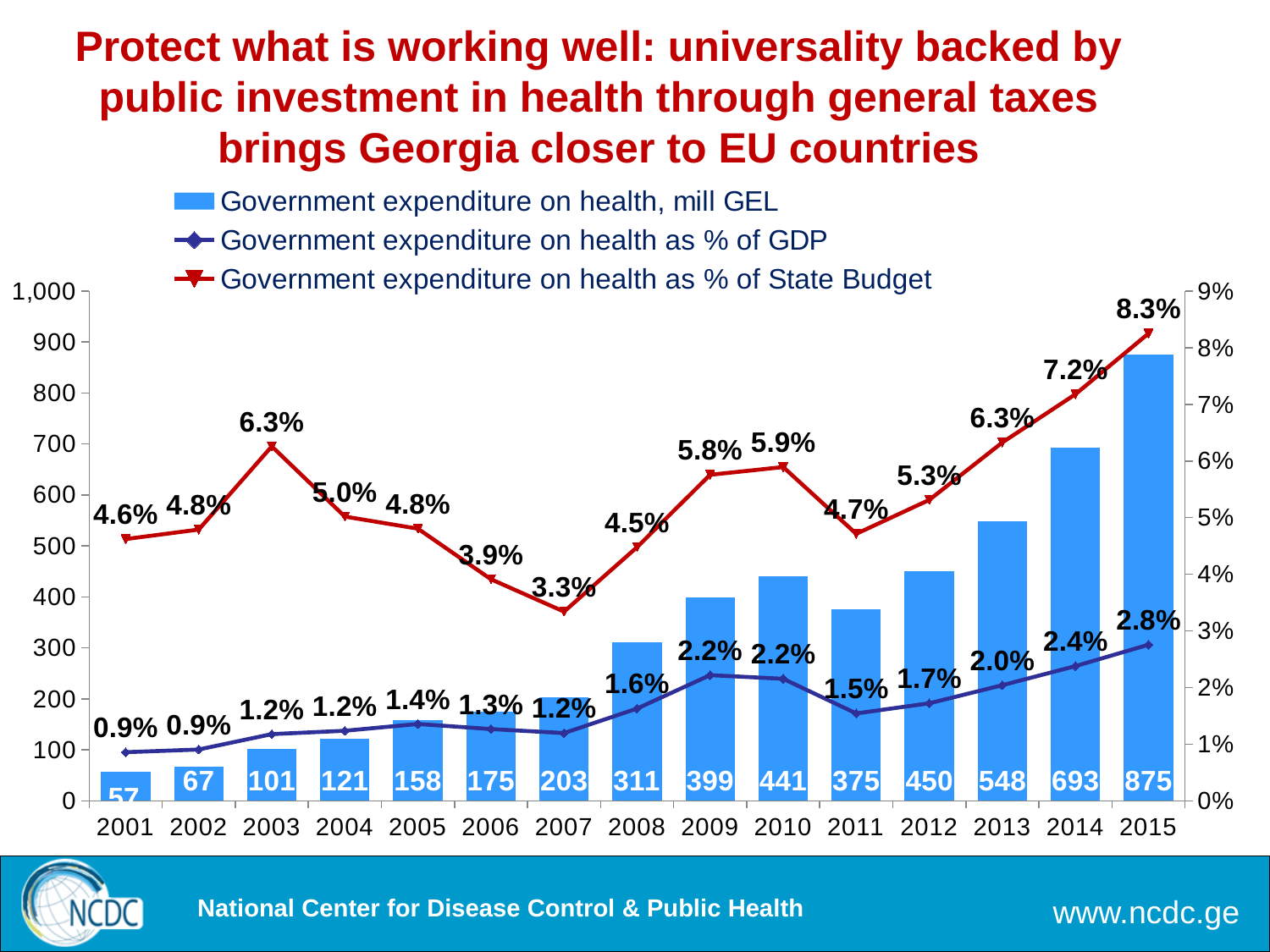
Which series is plotted with the red line? Government expenditure on health as % of State Budget What was government expenditure on health in mill GEL in 2015? 875 In which year was government expenditure on health as % of State Budget highest? 2015 Does government expenditure on health as % of GDP rise or fall from 2011 to 2015? Rise Which year had higher government expenditure on health in mill GEL, 2010 or 2011? 2010 What kind of chart is used for the government expenditure on health in mill GEL series? Bar chart What was government expenditure on health as % of State Budget in 2007? 3.3% In which year was government expenditure on health in mill GEL lowest? 2001 What was government expenditure on health as % of GDP in 2009? 2.2% How many years are shown on the x axis? 15 What is the difference in government expenditure on health in mill GEL between 2015 and 2014? 182 How many series does the legend list? 3